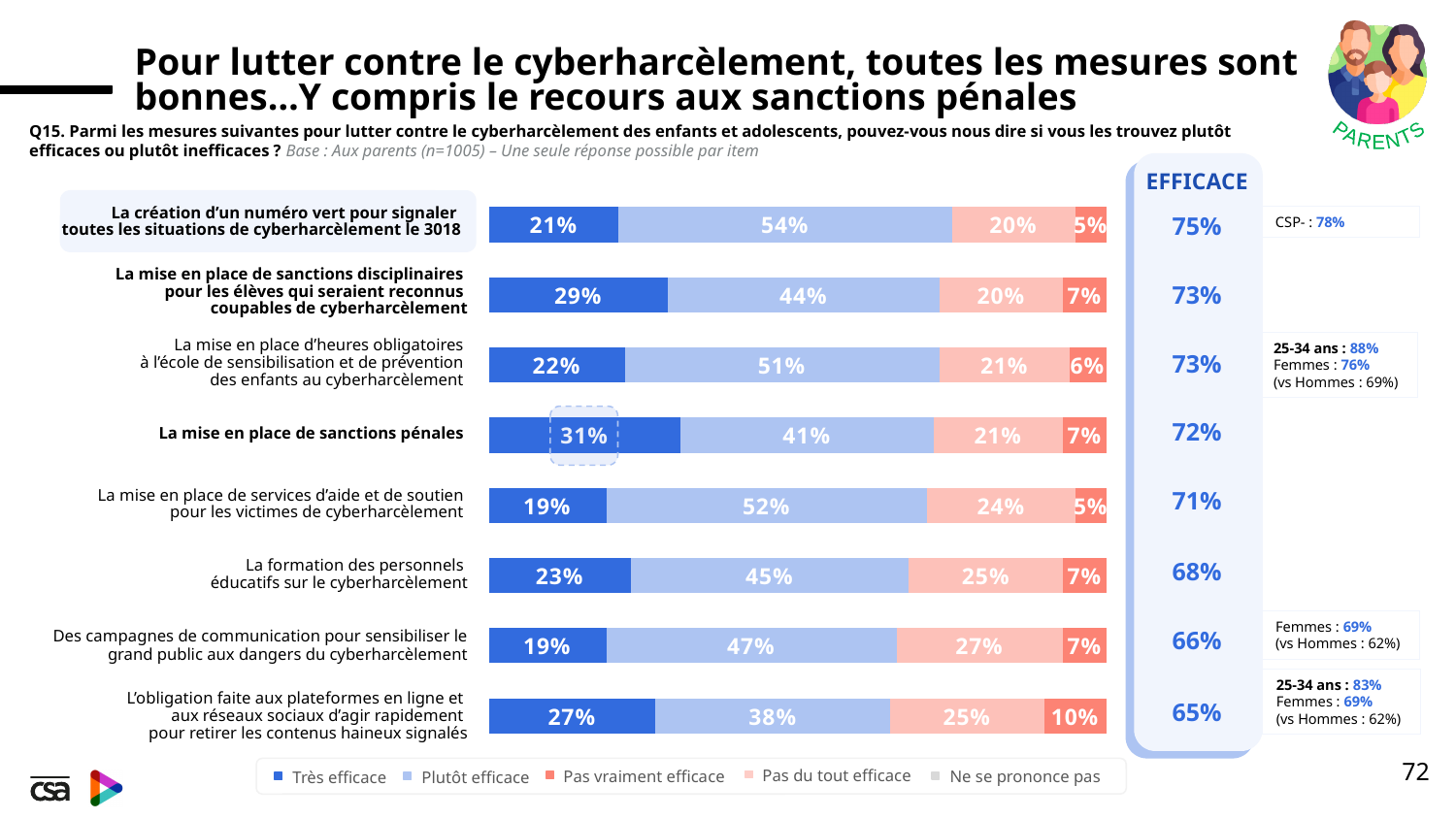
What is the combined 'Très efficace' and 'Plutôt efficace' total for 'La mise en place de services d'aide et de soutien pour les victimes de cyberharcèlement'? 71% What is the EFFICACE total shown for 'La formation des personnels éducatifs sur le cyberharcèlement'? 68% What percentage of parents find the creation of a green number (3018) 'Très efficace'? 21% What is the difference between the 'Très efficace' values for 'La mise en place de sanctions pénales' and 'La mise en place de sanctions disciplinaires'? 2% How many measures are listed in the chart? 8 What is the 'Pas du tout efficace' value for 'L'obligation faite aux plateformes en ligne et aux réseaux sociaux d'agir rapidement pour retirer les contenus haineux signalés'? 10% What is the 'Plutôt efficace' value for 'La mise en place de sanctions pénales'? 41% Which has a higher 'Pas vraiment efficace' value: 'Des campagnes de communication pour sensibiliser le grand public' or 'La création d'un numéro vert'? Des campagnes de communication pour sensibiliser le grand public Which measure has the lowest 'Plutôt efficace' percentage? L'obligation faite aux plateformes en ligne et aux réseaux sociaux d'agir rapidement pour retirer les contenus haineux signalés Which measure has the highest 'Très efficace' percentage? La mise en place de sanctions pénales What type of chart is shown on the slide? Stacked bar chart How many series does the legend list? 5